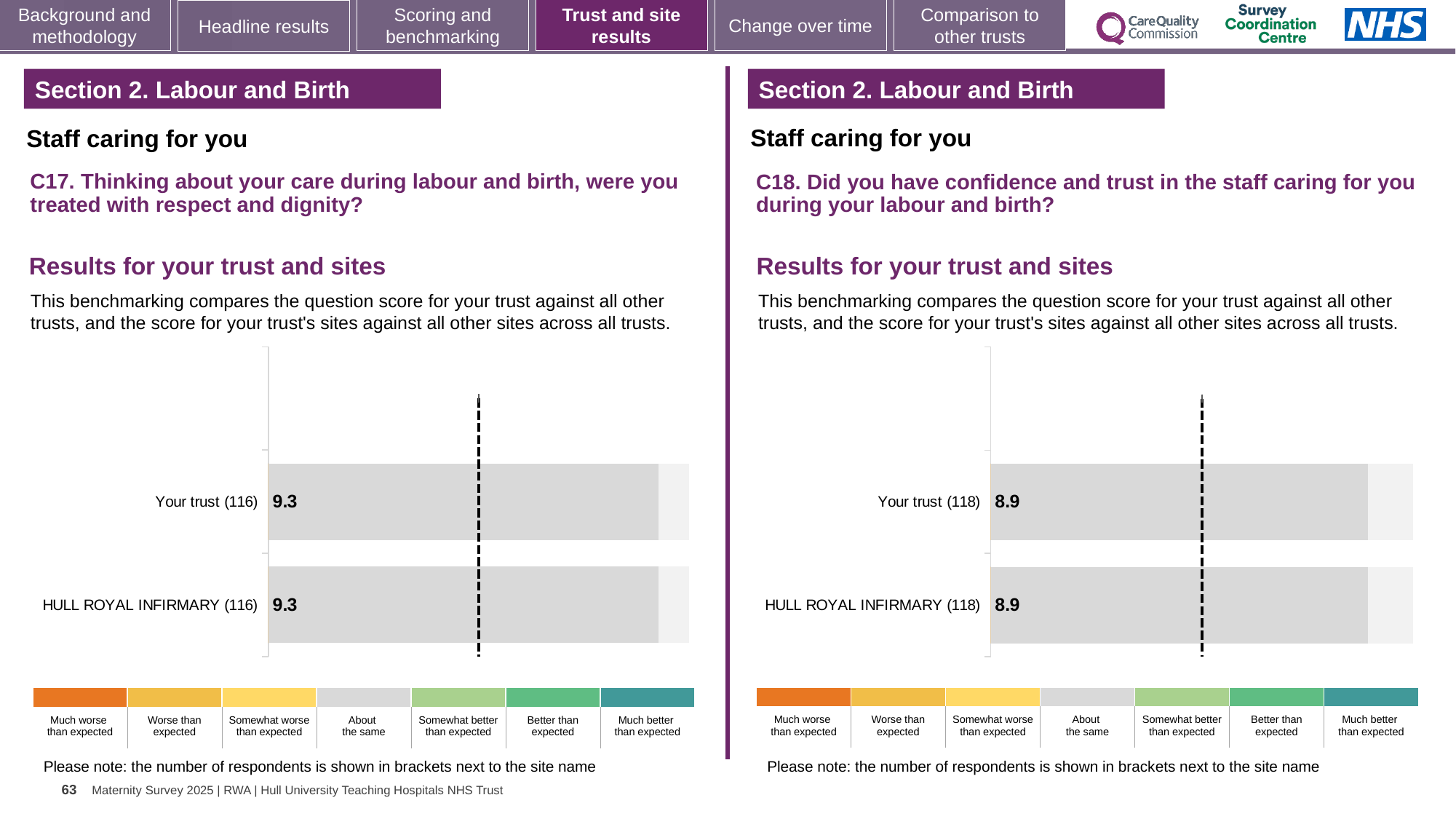
In the C18 chart on the right, what is the score for Your trust? 8.9 How many bars are plotted in the C17 chart on the left? 2 In the C18 chart on the right, what is the difference between the Your trust score and the HULL ROYAL INFIRMARY score? 0 In the C17 chart on the left, what is the difference between the Your trust score and the HULL ROYAL INFIRMARY score? 0 In the C17 chart on the left, what is the score for Your trust? 9.3 In the C17 chart on the left, what is the score for HULL ROYAL INFIRMARY? 9.3 Is the Your trust score in the C17 chart on the left larger than the Your trust score in the C18 chart on the right? Yes How many bars are plotted in the C18 chart on the right? 2 In the C18 chart on the right, how many respondents are shown in brackets next to HULL ROYAL INFIRMARY? 118 In the C17 chart on the left, how many respondents are shown in brackets next to Your trust? 116 In the C18 chart on the right, what is the score for HULL ROYAL INFIRMARY? 8.9 What kind of chart is used for the C17 results on the left? Bar chart